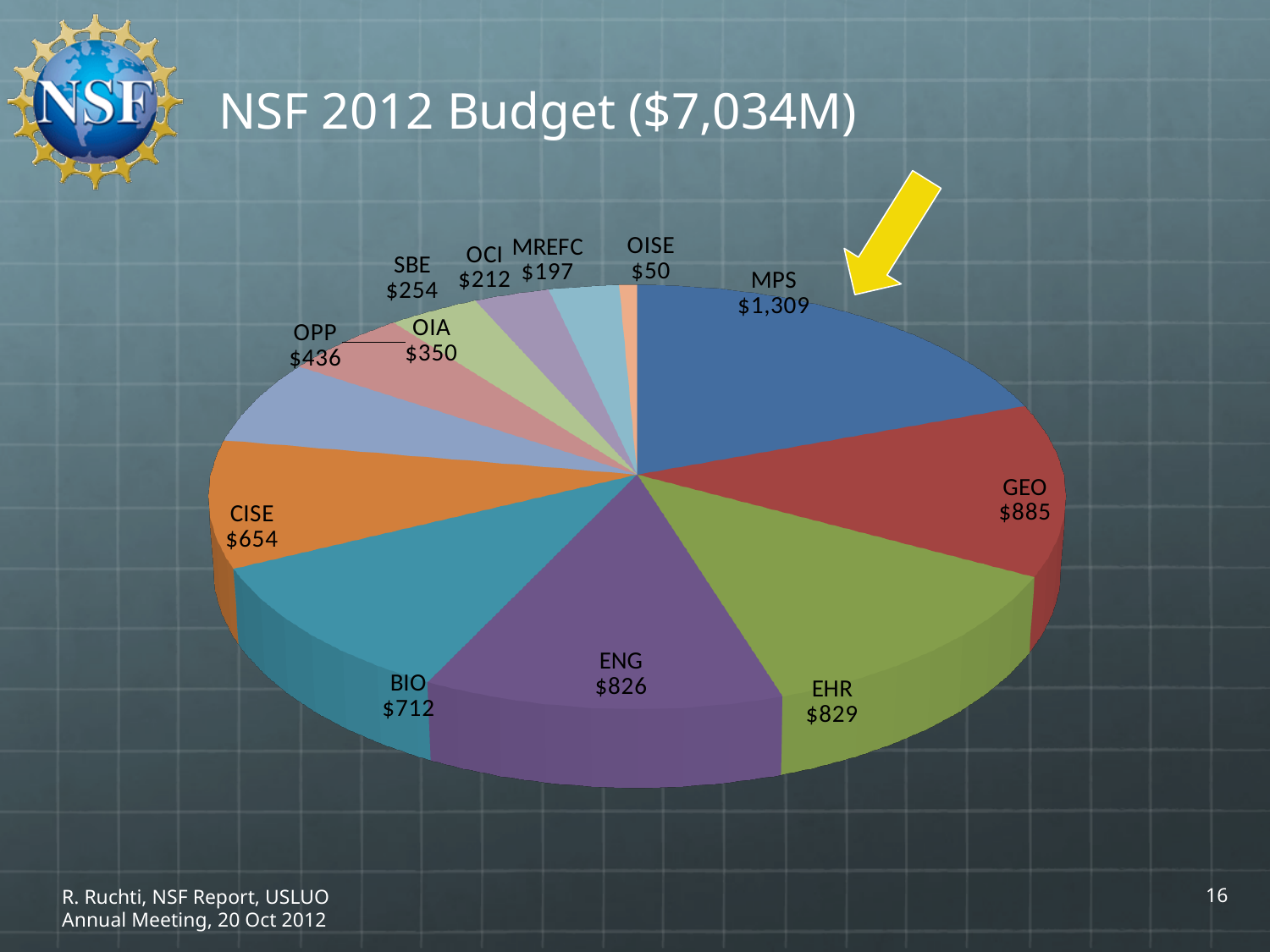
What is the value for GEO? $885 What is the value for OISE? $50 Which category has the smallest slice? OISE What is the difference between the values for MPS and GEO? $424 What is the value for OPP? $436 What is the title of the chart? NSF 2012 Budget ($7,034M) Which category has the largest slice? MPS What is the difference between the values for BIO and CISE? $58 How many slices does the pie chart have? 12 What kind of chart is shown on the slide? pie chart What is the value for MPS? $1,309 Which is larger, the value for OIA or the value for SBE? OIA